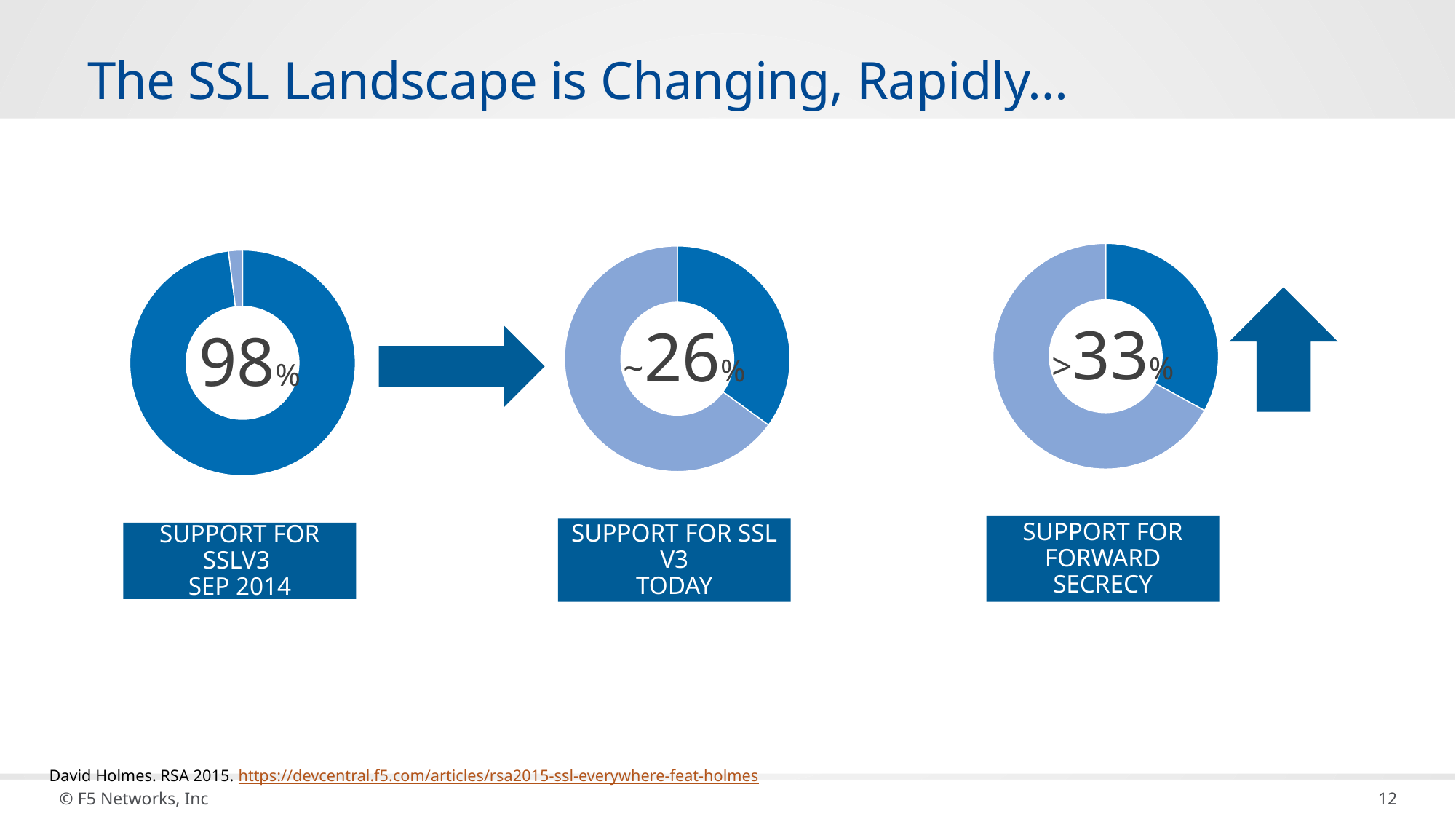
What is the label under the rightmost donut chart? Support for Forward Secrecy In the 'Support for SSL v3 Today' chart, what figure is printed in the centre? ~26% Is the value shown in the 'Support for Forward Secrecy' chart greater or less than 50%? less Is the value shown in the 'Support for SSL v3 Today' chart greater or less than 50%? less What kind of chart is used to show support for SSLv3 in Sep 2014? Donut (pie) chart In the 'Support for SSLv3 Sep 2014' chart, what value is printed in the centre? 98% Is the value shown in the 'Support for SSLv3 Sep 2014' chart greater or less than 90%? greater In the 'Support for Forward Secrecy' chart, what figure is printed in the centre? >33% Did support for SSLv3 rise or fall from Sep 2014 to today? fall How many donut charts are shown on the slide? 3 Which is larger: support for SSLv3 in Sep 2014 or support for SSL v3 today? Support for SSLv3 Sep 2014 Which of the three charts shows the highest value? Support for SSLv3 Sep 2014